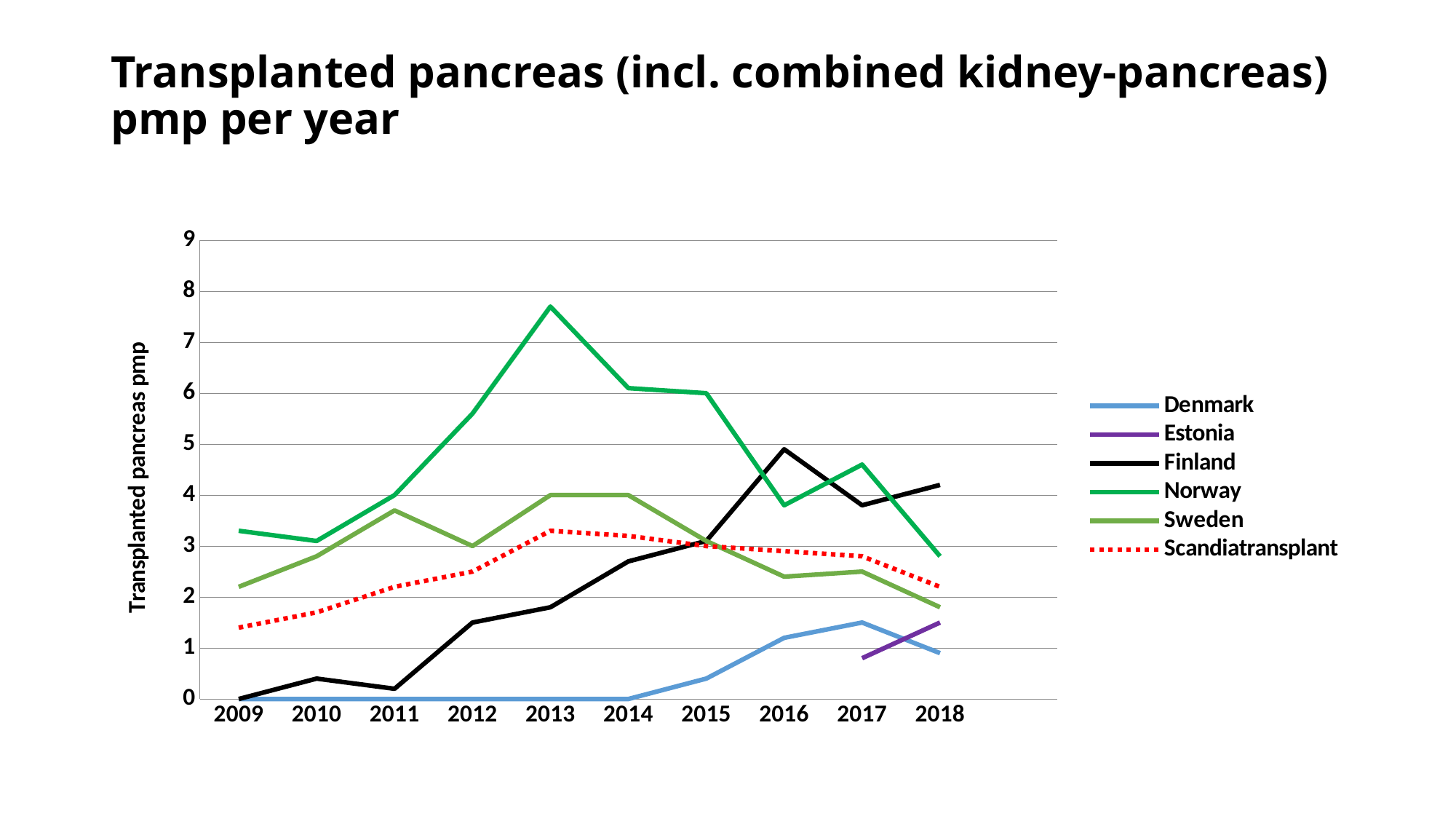
Is the value for Norway in 2013 greater or less than 7? greater Is the value for Scandiatransplant in 2009 greater or less than 2? less How many series does the legend list? 6 In 2016, which is larger: the value for Finland or the value for Norway? Finland What kind of chart is shown on the slide? line chart Does the Norway line rise or fall from 2013 to 2018? fall Which series is drawn as a dotted line? Scandiatransplant Which series has the highest value in 2013? Norway How many years are shown on the x axis? 10 Which series has the lowest value in 2018? Denmark What is the value for Sweden in 2013? 4 What is the value for Denmark in 2012? 0